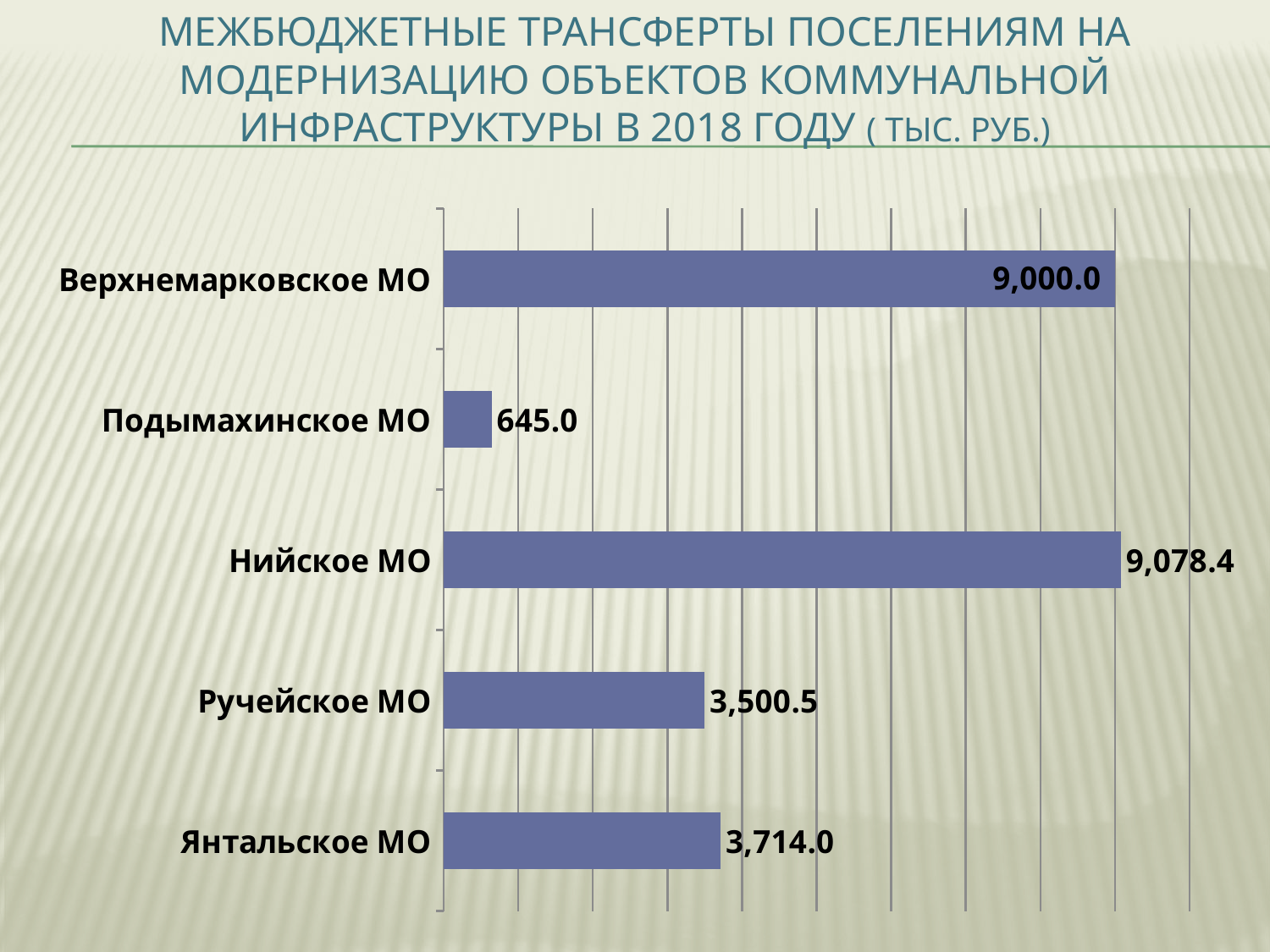
Which category has the highest value? Нийское МО What is the value for Ручейское МО? 3,500.5 What is the value for Нийское МО? 9,078.4 How many categories are shown in the chart? 5 What is the value for Подымахинское МО? 645.0 What is the difference between the values for Янтальское МО and Ручейское МО? 213.5 Which category has the lowest value? Подымахинское МО What kind of chart is shown on the slide? Bar chart Which is larger, the value for Ручейское МО or the value for Янтальское МО? Янтальское МО What is the difference between the values for Нийское МО and Верхнемарковское МО? 78.4 What is the value for Янтальское МО? 3,714.0 What is the value for Верхнемарковское МО? 9,000.0